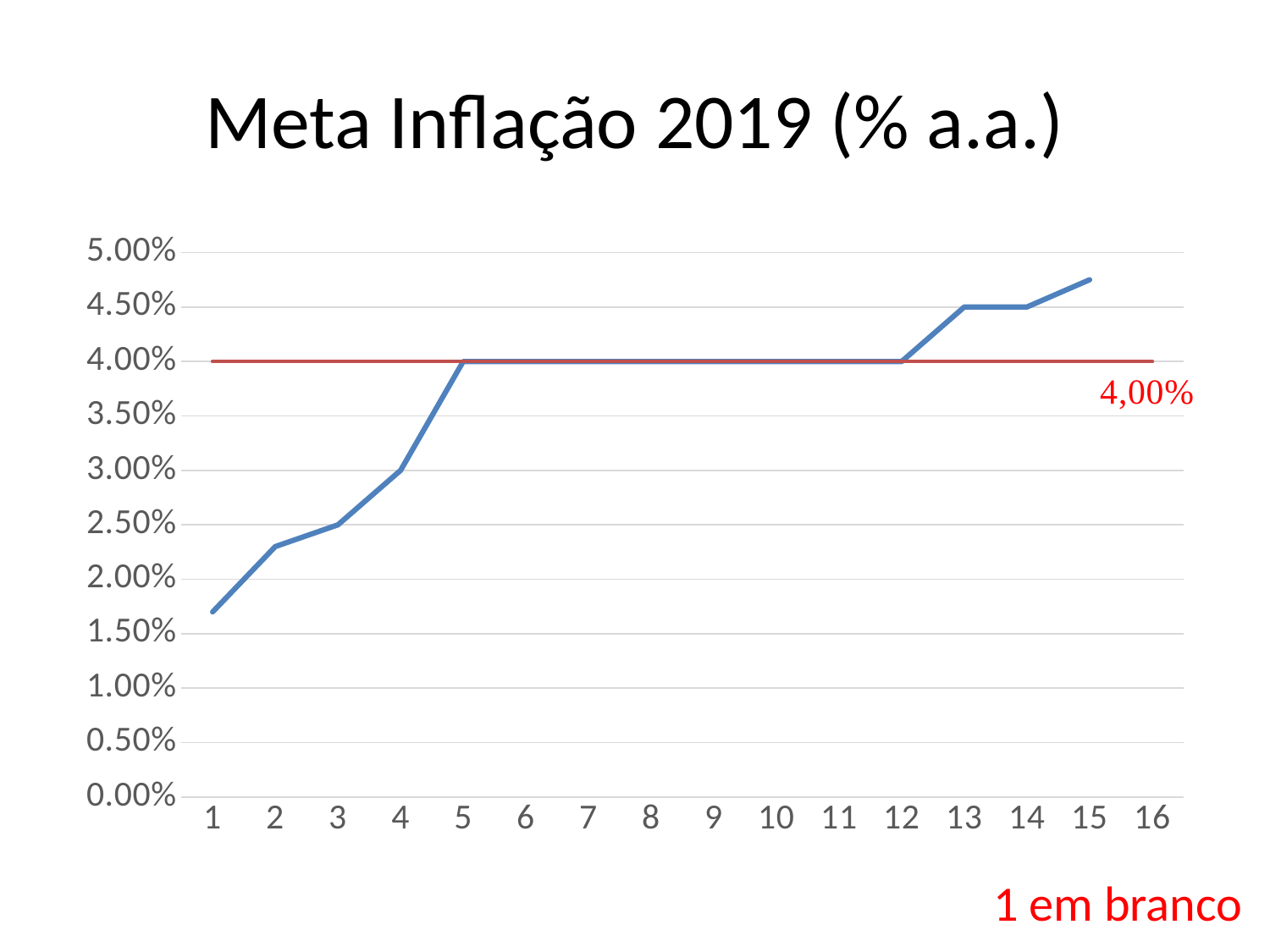
Is the value of the blue line at category 15 greater or less than 4.50%? greater What is the value of the blue line at category 4? 3.00% At which category does the blue line have its lowest value? 1 What is the difference between the blue line's value at category 13 and at category 3? 2.00% Does the blue line generally rise or fall from category 1 to category 15? rise What is the value of the blue line at category 13? 4.50% What is the title of the chart? Meta Inflação 2019 (% a.a.) What kind of chart is shown on the slide? line chart What is the value of the blue line at category 3? 2.50% At which category does the blue line reach its highest value? 15 Is the value of the blue line at category 1 greater or less than 2.00%? less What value is labelled on the red horizontal line? 4,00%